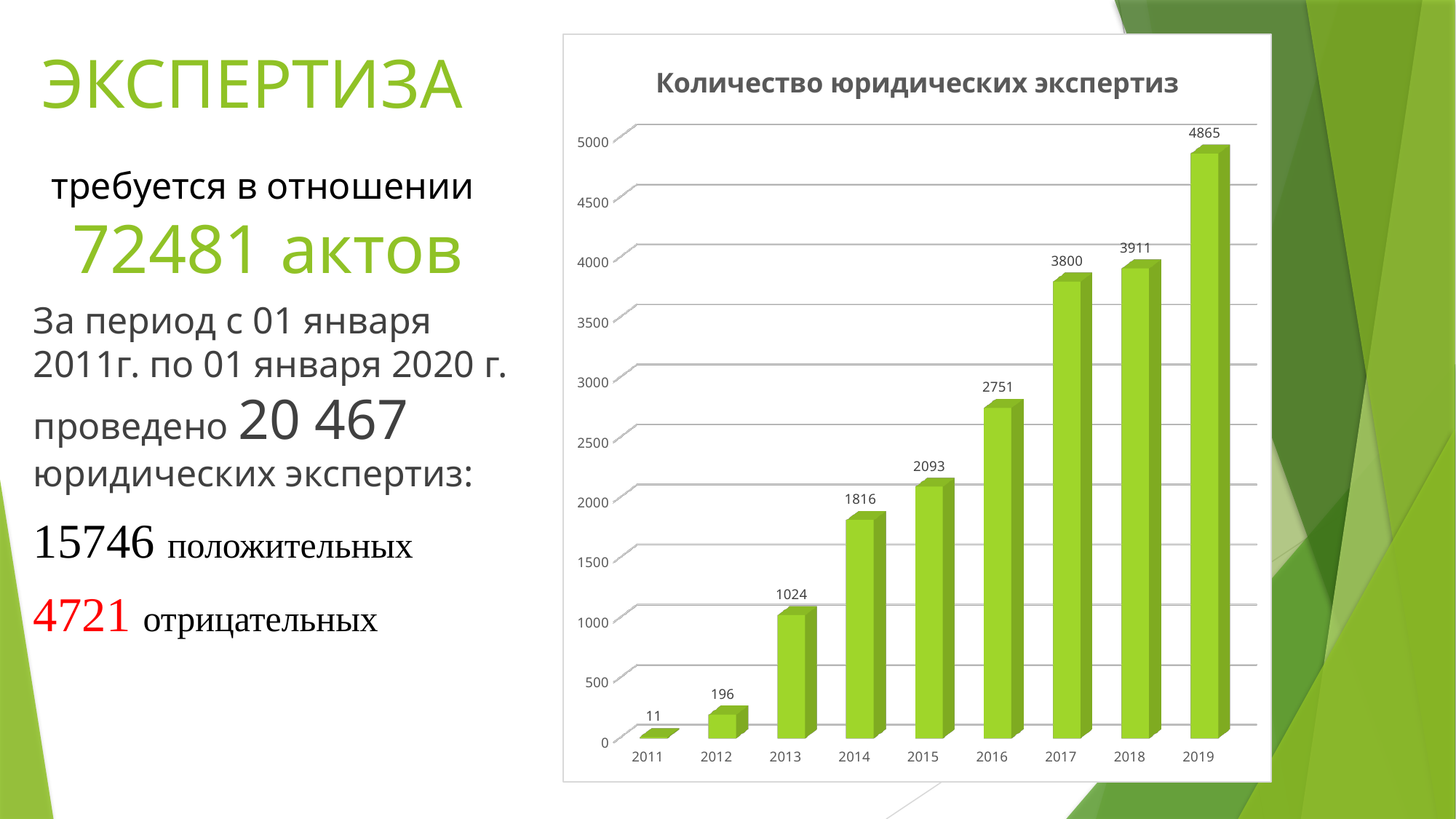
Which year has the highest value in the chart? 2019 Do the values rise or fall from 2011 to 2019? rise Is the value for 2017 greater or less than 3500? greater What is the difference between the values for 2015 and 2014? 277 Which is larger, the value for 2014 or the value for 2012? 2014 What is the value for 2016 in the chart? 2751 What is the value for 2013 in the chart? 1024 What is the difference between the values for 2018 and 2017? 111 What kind of chart is shown on the slide? bar chart Which year has the lowest value in the chart? 2011 What is the value for 2019 in the chart? 4865 How many years are shown on the x axis of the chart? 9